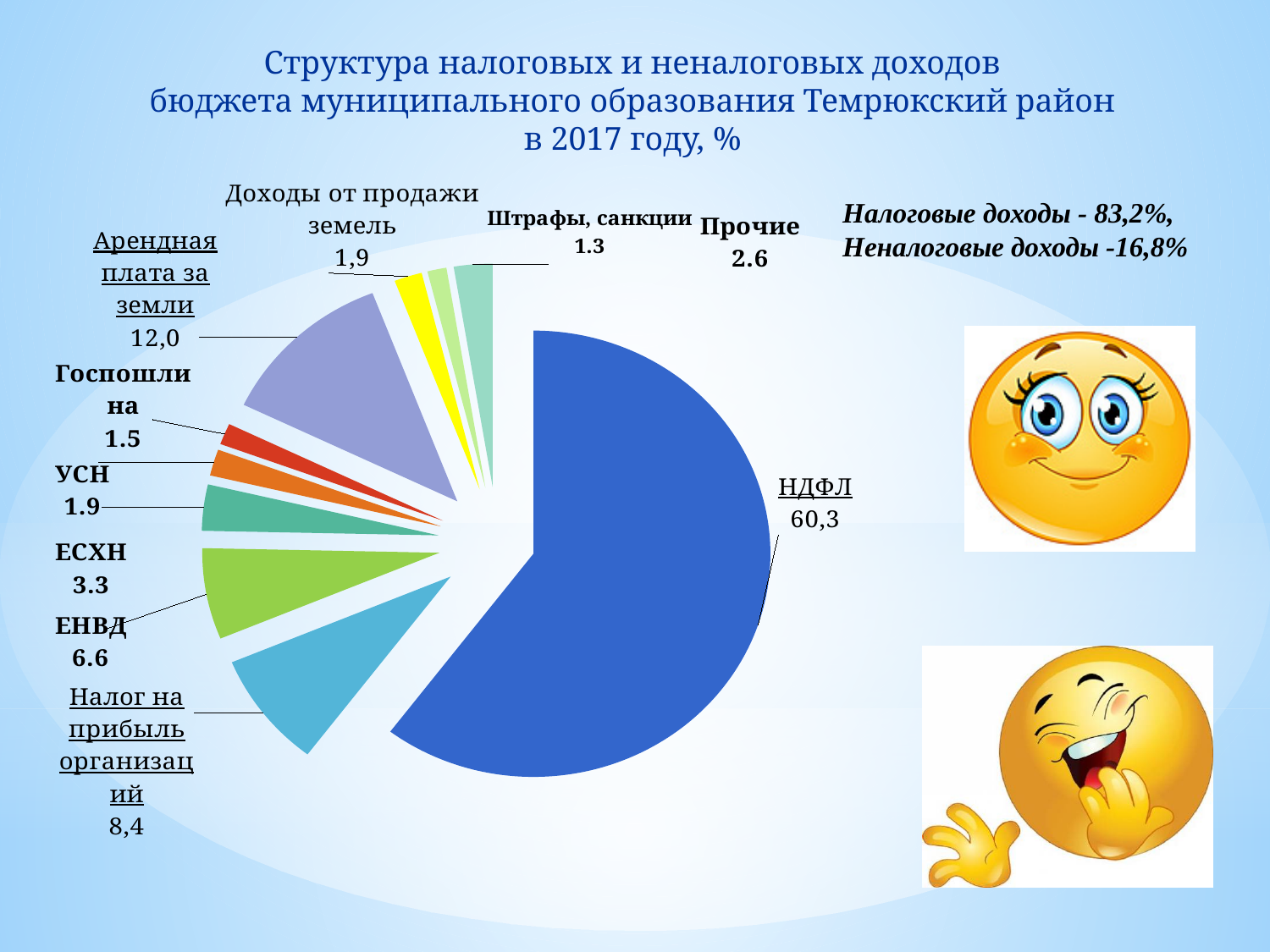
According to the text on the slide, what share of revenues are tax revenues (Налоговые доходы)? 83,2% What is the value for ЕНВД? 6.6 What is the value for Арендная плата за земли? 12,0 What is the difference between the values for Арендная плата за земли and Налог на прибыль организаций? 3,6 What is the value for НДФЛ? 60,3 What type of chart is shown on the slide? pie chart What is the value for Налог на прибыль организаций? 8,4 How many slices does the pie chart have? 10 What is the value for Штрафы, санкции? 1.3 Which is larger, ЕНВД or ЕСХН? ЕНВД Which category has the largest slice of the pie? НДФЛ Which category has the smallest slice of the pie? Штрафы, санкции